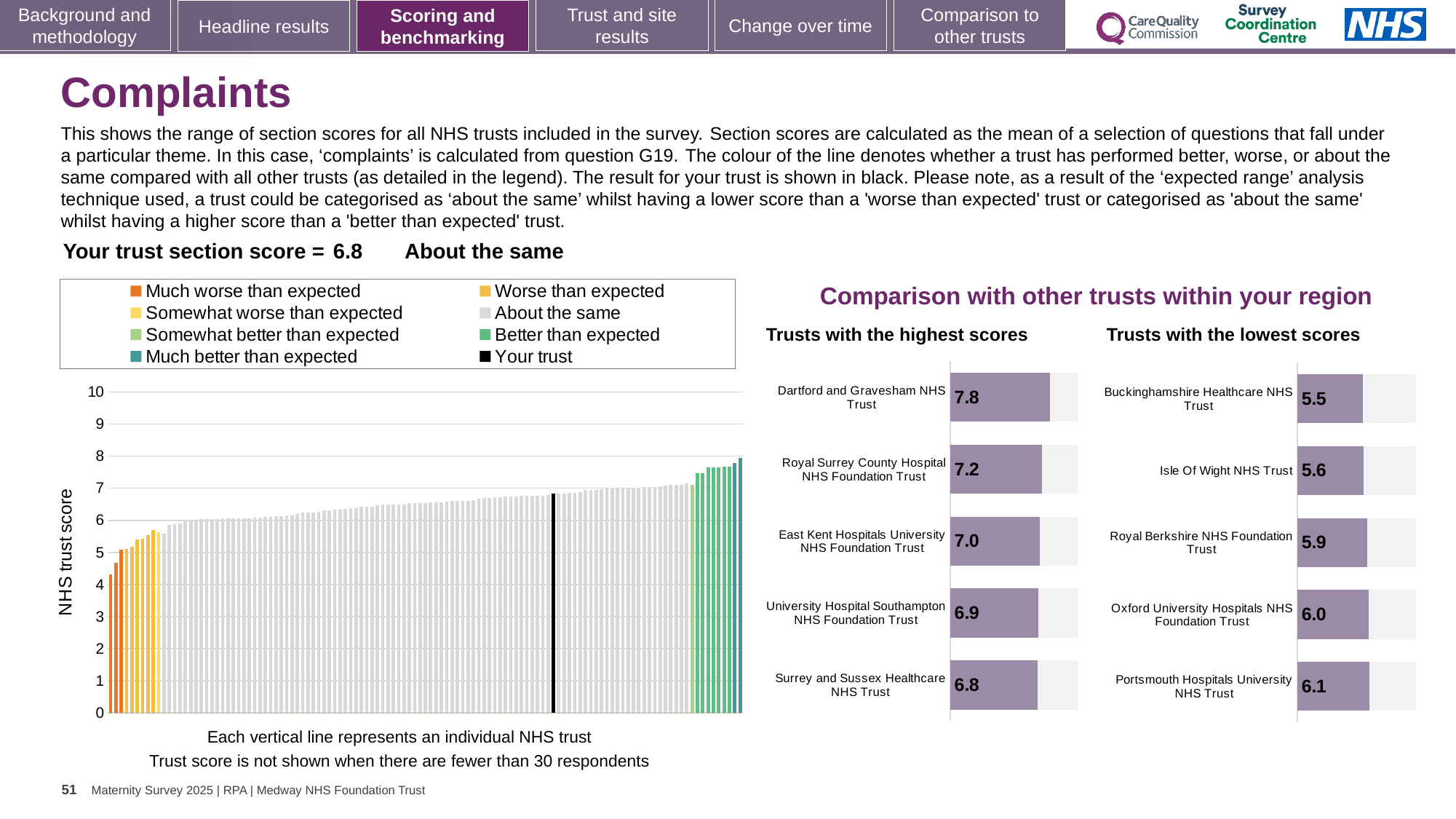
How many entries does the legend of the main chart on the left list? 8 In the 'Trusts with the lowest scores' chart, which trust has the lowest score? Buckinghamshire Healthcare NHS Trust What kind of chart is the main chart on the left showing all NHS trusts? bar chart In the main chart on the left showing all NHS trusts, is the value of the black bar (your trust) greater or less than 6? greater In the 'Trusts with the lowest scores' chart, which has the higher score: Isle Of Wight NHS Trust or Portsmouth Hospitals University NHS Trust? Portsmouth Hospitals University NHS Trust How many trusts are listed in the 'Trusts with the lowest scores' chart? 5 In the 'Trusts with the lowest scores' chart, what is the score for Oxford University Hospitals NHS Foundation Trust? 6.0 In the 'Trusts with the highest scores' chart, what is the difference between the scores of Dartford and Gravesham NHS Trust and Royal Surrey County Hospital NHS Foundation Trust? 0.6 In the main chart on the left, do the trust scores rise or fall from left to right? rise In the 'Trusts with the highest scores' chart, which trust has the lowest score shown? Surrey and Sussex Healthcare NHS Trust In the 'Trusts with the lowest scores' chart, what is the score for Royal Berkshire NHS Foundation Trust? 5.9 In the 'Trusts with the highest scores' chart, what is the score for Dartford and Gravesham NHS Trust? 7.8